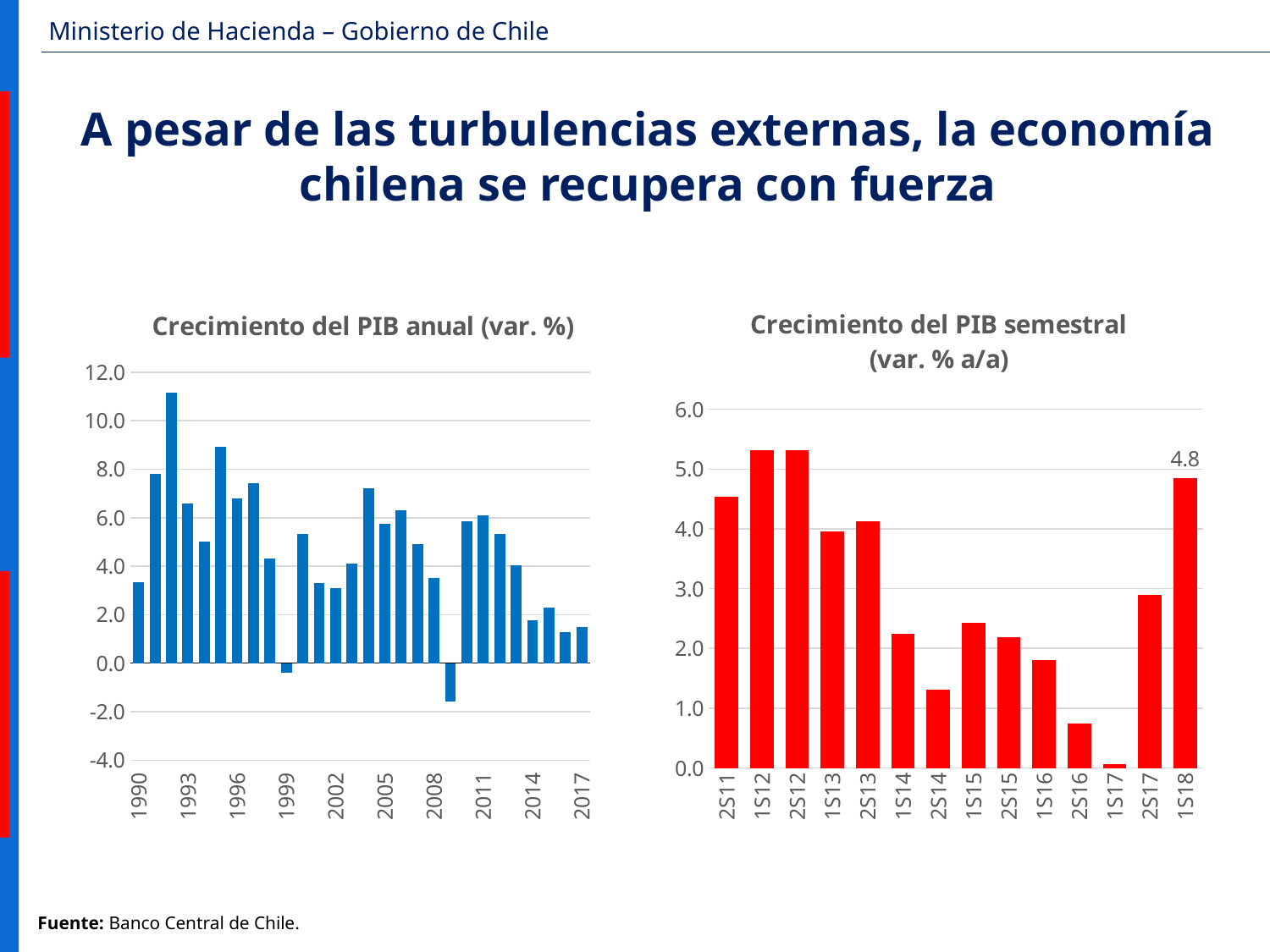
What kind of chart is the 'Crecimiento del PIB semestral (var. % a/a)' chart? Bar chart What colour are the bars in the 'Crecimiento del PIB semestral (var. % a/a)' chart? Red How many bars are plotted in the 'Crecimiento del PIB semestral (var. % a/a)' chart? 14 In the 'Crecimiento del PIB semestral (var. % a/a)' chart, what is the value for 1S18? 4.8 In the 'Crecimiento del PIB semestral (var. % a/a)' chart, is the value for 2S11 greater or less than 4.0? greater In the 'Crecimiento del PIB anual (var. %)' chart, is the value for 1990 greater or less than 2.0? greater In the 'Crecimiento del PIB semestral (var. % a/a)' chart, which is larger, the value for 2S17 or the value for 1S16? 2S17 In the 'Crecimiento del PIB semestral (var. % a/a)' chart, which period has the lowest value? 1S17 In the 'Crecimiento del PIB semestral (var. % a/a)' chart, is the value for 2S16 greater or less than 1.0? less In the 'Crecimiento del PIB anual (var. %)' chart, how many bars fall below 0.0? 2 In the 'Crecimiento del PIB anual (var. %)' chart, do the values rise or fall from 2011 to 2014? fall What kind of chart is the 'Crecimiento del PIB anual (var. %)' chart? Bar chart